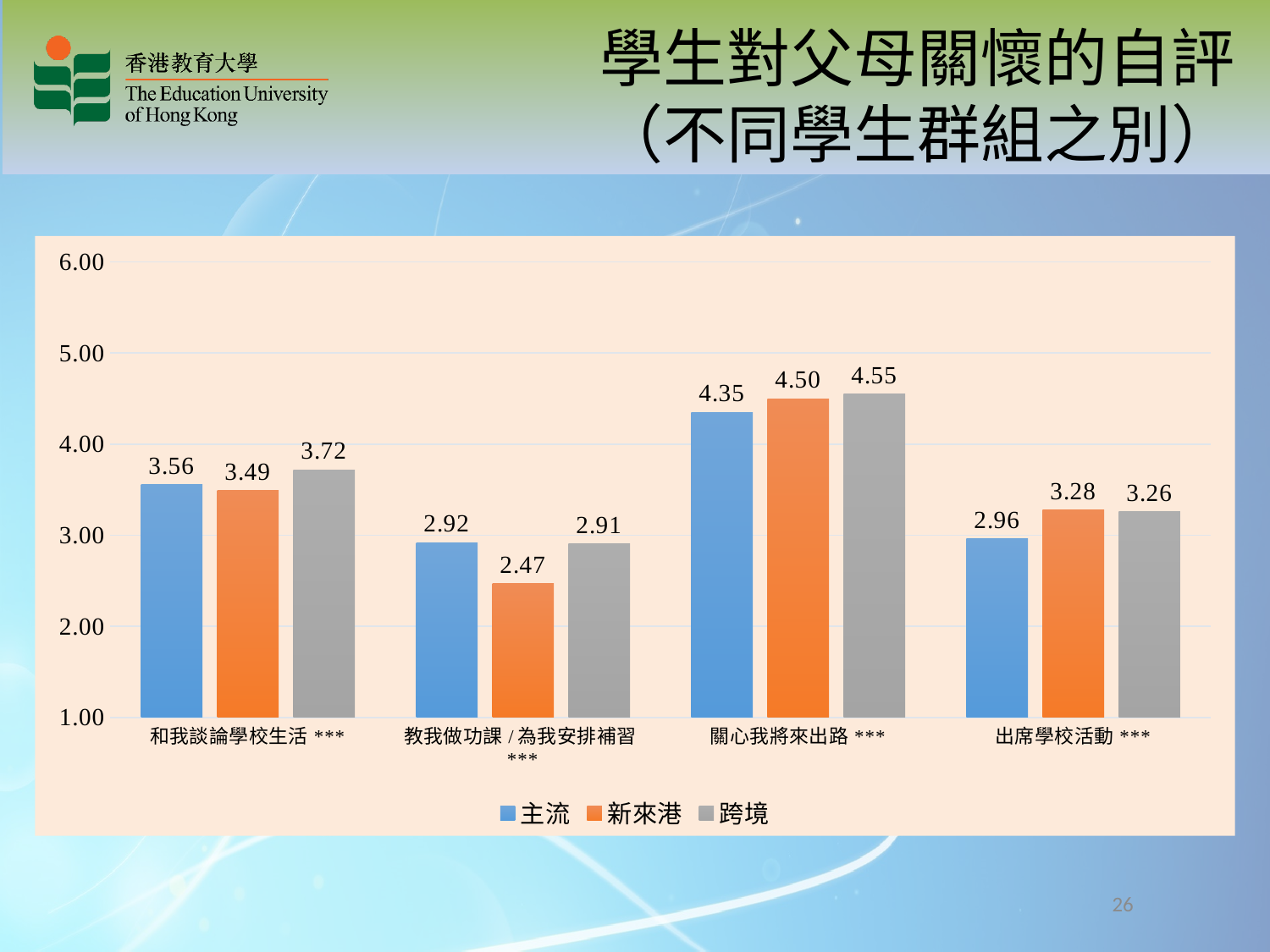
How many categories are shown on the x axis? 4 What is the value for 跨境 in the 關心我將來出路 *** category? 4.55 Which colour represents the 跨境 series in the chart? grey What is the value for 主流 in the 和我談論學校生活 *** category? 3.56 Which series has the lowest value in the 教我做功課 / 為我安排補習 *** category? 新來港 What is the value for 主流 in the 出席學校活動 *** category? 2.96 Which category has the highest value for 新來港? 關心我將來出路 *** What is the value for 新來港 in the 教我做功課 / 為我安排補習 *** category? 2.47 In the 出席學校活動 *** category, which is larger: the value for 新來港 or the value for 主流? 新來港 What kind of chart is shown on the slide? bar chart How many series does the legend list? 3 What is the difference between the 跨境 and 主流 values in the 和我談論學校生活 *** category? 0.16